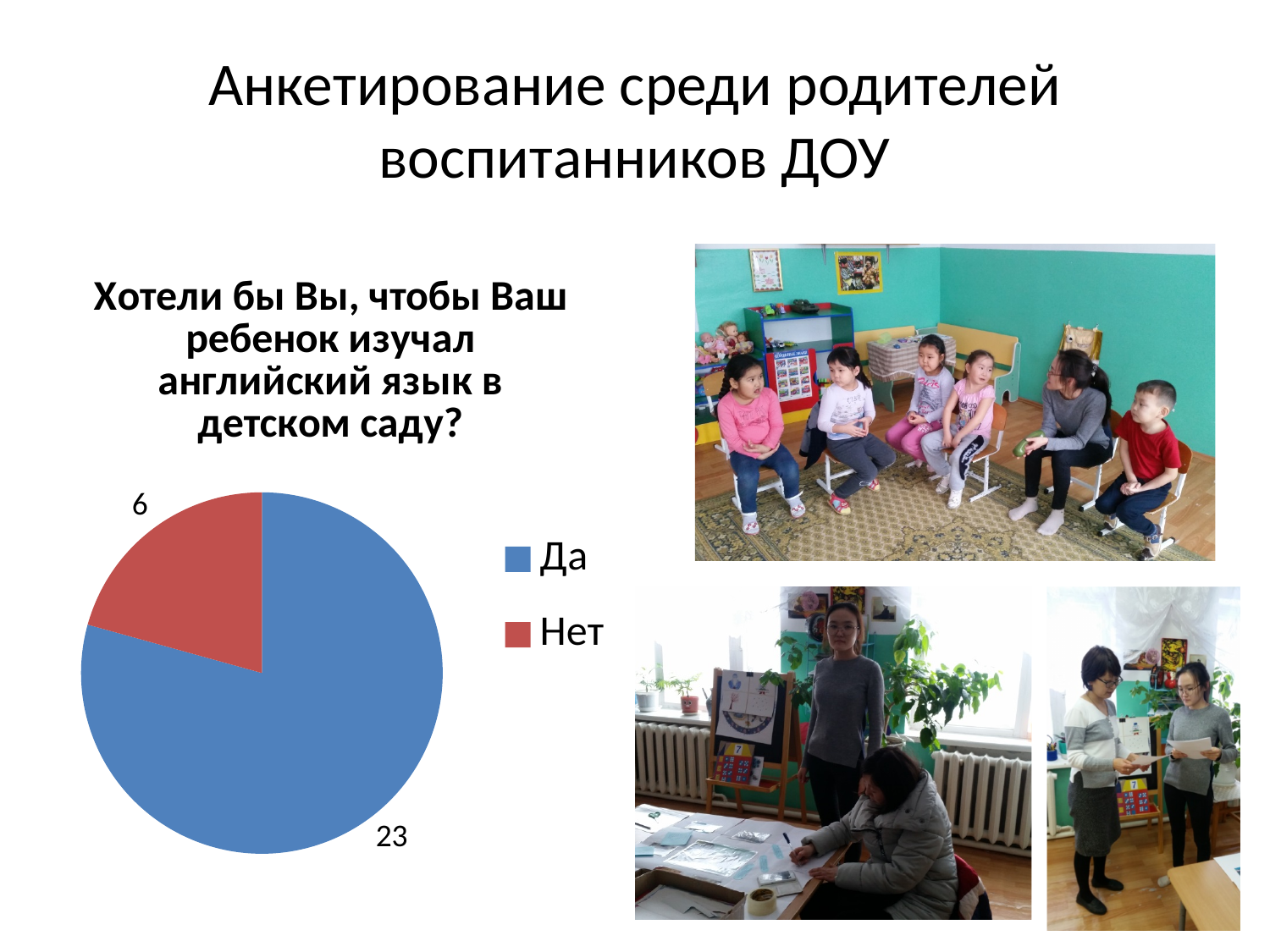
What fraction of all responses in the pie chart are "Да"? 23 out of 29 How many entries does the legend of the pie chart list? 2 Which answer has the largest slice in the pie chart? Да How many respondents answered "Нет" in the pie chart? 6 What type of chart is shown on the slide? pie chart How many respondents answered "Да" in the pie chart? 23 What is the difference between the number of "Да" and "Нет" answers? 17 What is the total number of responses shown in the pie chart? 29 Which answer has the smallest slice in the pie chart? Нет Which is larger: the number of "Да" answers or the number of "Нет" answers? Да What colour is the "Нет" slice in the pie chart? red How many categories does the pie chart have? 2